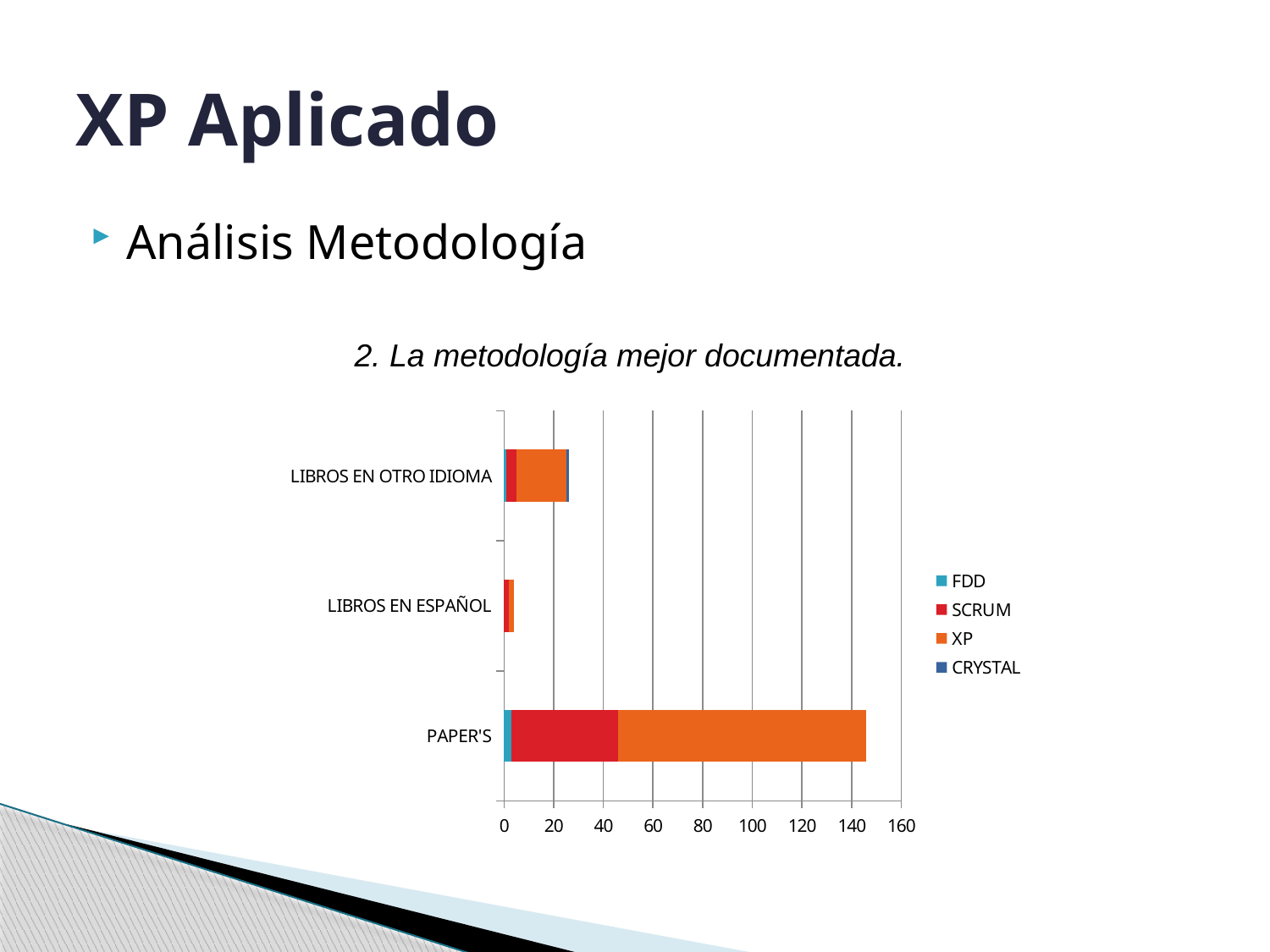
Is the total value for LIBROS EN OTRO IDIOMA greater or less than 20? greater What kind of chart is shown on the slide? Stacked bar chart Is the total value for LIBROS EN ESPAÑOL greater or less than 20? less How many series does the chart's legend list? 4 Which category has the longest total bar? PAPER'S Within the PAPER'S bar, which series has the largest segment, SCRUM or XP? XP Which series is shown in orange in the legend? XP Which is larger, the total bar for LIBROS EN OTRO IDIOMA or for LIBROS EN ESPAÑOL? LIBROS EN OTRO IDIOMA How many categories are shown on the vertical axis of the chart? 3 Which category has the shortest total bar? LIBROS EN ESPAÑOL Is the total value for PAPER'S greater or less than 140? greater What is the title of the chart? 2. La metodología mejor documentada.